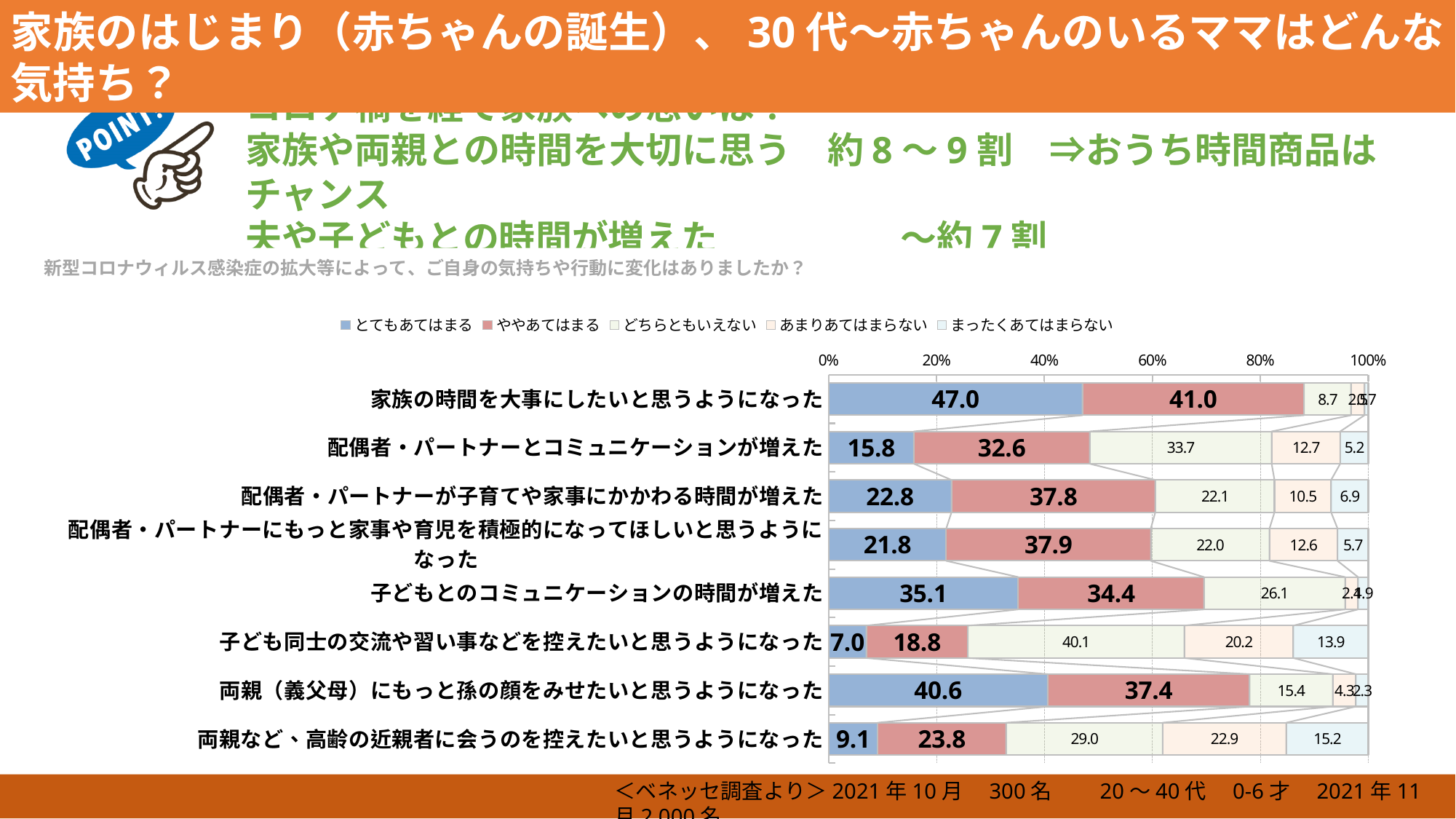
How many categories (statements) are plotted in the chart? 8 What is the 「まったくあてはまらない」 value for 「両親など、高齢の近親者に会うのを控えたいと思うようになった」? 15.2 How many series does the legend list? 5 Which is larger: the 「あまりあてはまらない」 value for 「子ども同士の交流や習い事などを控えたいと思うようになった」 or for 「両親など、高齢の近親者に会うのを控えたいと思うようになった」? 両親など、高齢の近親者に会うのを控えたいと思うようになった What is the difference between the 「とてもあてはまる」 values for 「家族の時間を大事にしたいと思うようになった」 and 「両親（義父母）にもっと孫の顔をみせたいと思うようになった」? 6.4 Which statement has the lowest 「とてもあてはまる」 value? 子ども同士の交流や習い事などを控えたいと思うようになった Which statement has the highest 「とてもあてはまる」 value? 家族の時間を大事にしたいと思うようになった What is the first series listed in the legend? とてもあてはまる What is the 「ややあてはまる」 value for 「配偶者・パートナーとコミュニケーションが増えた」? 32.6 What is the 「どちらともいえない」 value for 「子ども同士の交流や習い事などを控えたいと思うようになった」? 40.1 What is the 「とてもあてはまる」 value for 「家族の時間を大事にしたいと思うようになった」? 47.0 What kind of chart is shown on the slide? Stacked bar chart